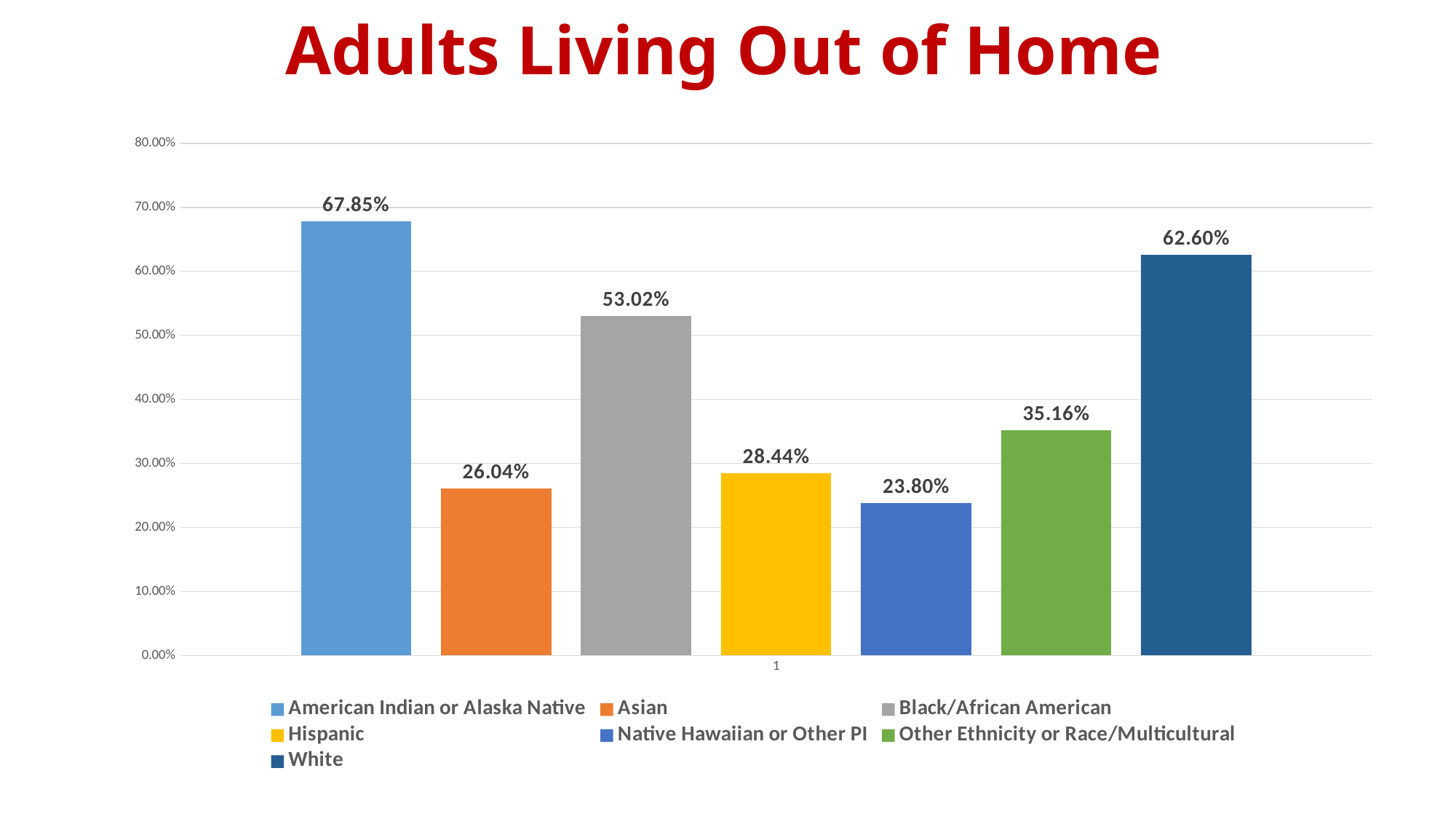
Which is larger, the value for Hispanic or the value for Asian? Hispanic How many series does the legend list? 7 What colour is the bar for Hispanic? yellow Is the value for Black/African American greater or less than 50.00%? greater What is the value for Other Ethnicity or Race/Multicultural? 35.16% Which group has the lowest value? Native Hawaiian or Other PI What is the value for American Indian or Alaska Native? 67.85% What kind of chart is shown on the slide? bar chart What is the value for Native Hawaiian or Other PI? 23.80% Which group has the highest value? American Indian or Alaska Native What is the difference between the values for White and Black/African American? 9.58% What is the title of the chart? Adults Living Out of Home